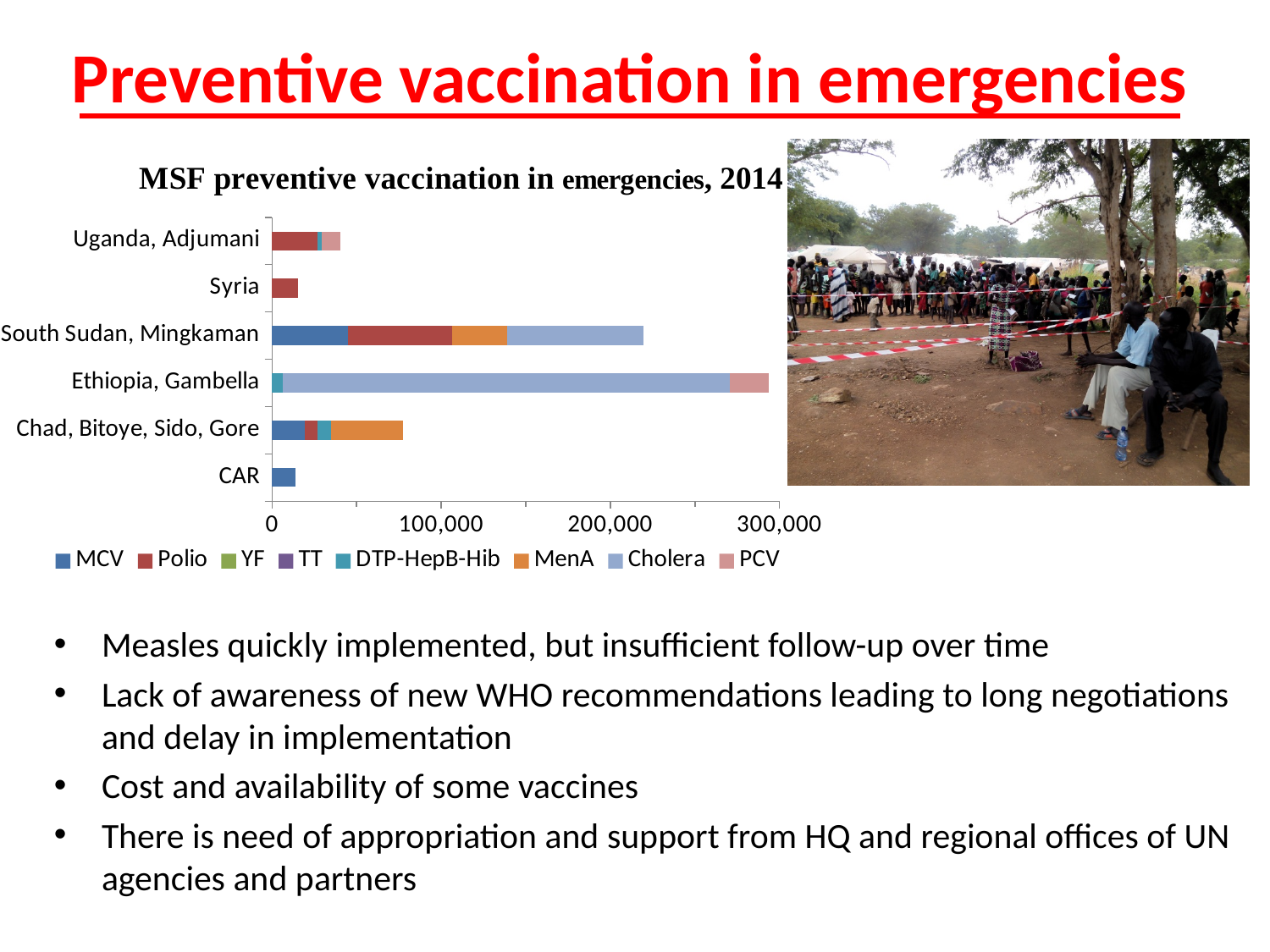
Is the total bar for South Sudan, Mingkaman greater or less than 200,000? greater Which vaccine series makes up the largest segment of the Ethiopia, Gambella bar? Cholera Which location has the longest total bar in the chart? Ethiopia, Gambella How many countries/locations are listed on the chart's vertical axis? 6 Which has a larger total bar: South Sudan, Mingkaman or Chad, Bitoye, Sido, Gore? South Sudan, Mingkaman Is the total bar for Chad, Bitoye, Sido, Gore greater or less than 100,000? less Is the total bar for Ethiopia, Gambella greater or less than 200,000? greater What kind of chart is shown on the slide? Stacked bar chart How many vaccine series does the chart legend list? 8 What is the title of the chart? MSF preventive vaccination in emergencies, 2014 Which has a larger total bar: Ethiopia, Gambella or South Sudan, Mingkaman? Ethiopia, Gambella